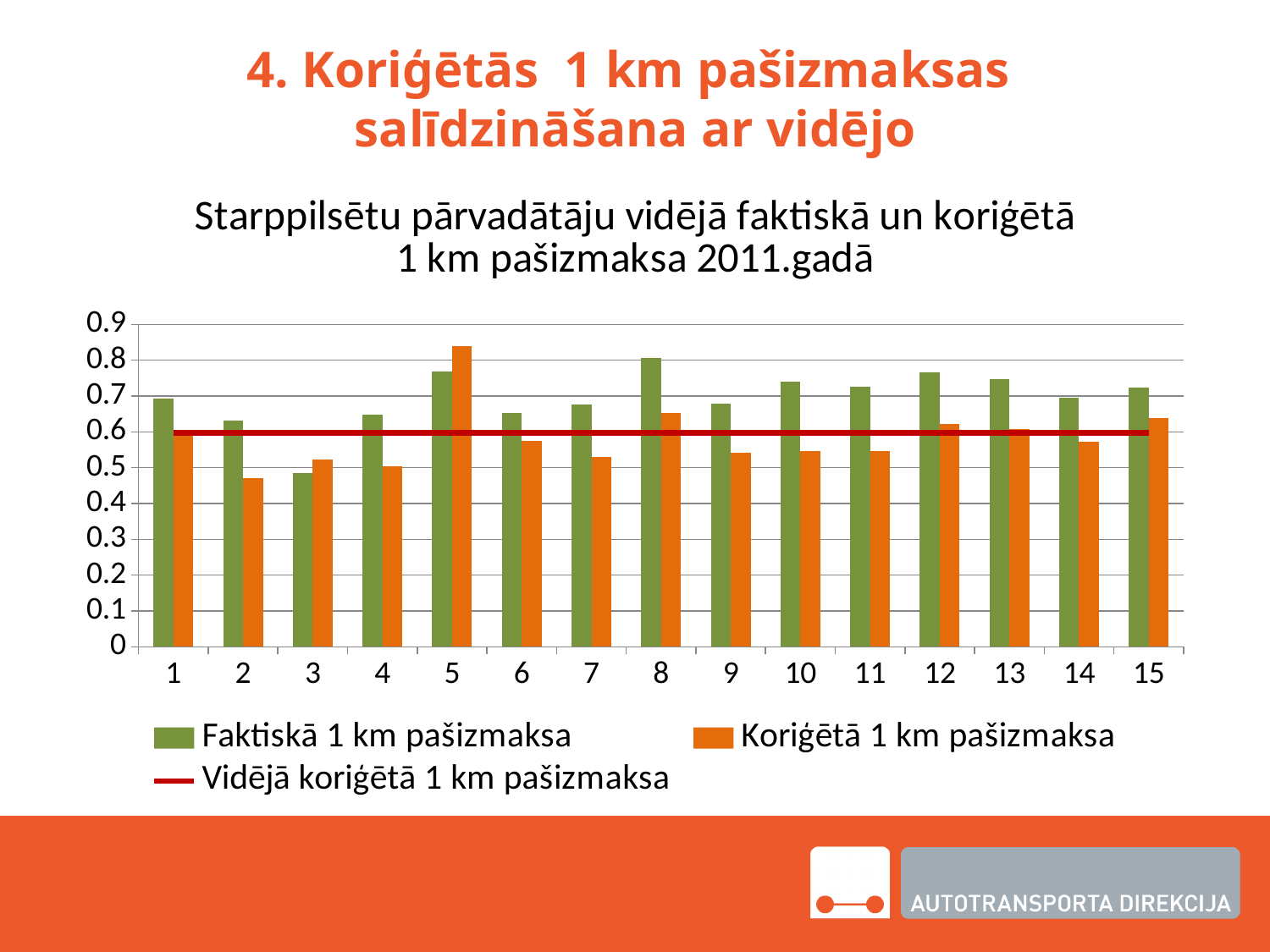
For category 5, which is larger: Faktiskā 1 km pašizmaksa or Koriģētā 1 km pašizmaksa? Koriģētā 1 km pašizmaksa How many series does the legend list? 3 Which category has the highest value for Koriģētā 1 km pašizmaksa? 5 Which category has the lowest value for Koriģētā 1 km pašizmaksa? 2 How many categories are shown on the x axis? 15 Which category has the lowest value for Faktiskā 1 km pašizmaksa? 3 Which category has the highest value for Faktiskā 1 km pašizmaksa? 8 What kind of chart is shown on the slide? combination bar and line chart Which series is drawn as a red horizontal line? Vidējā koriģētā 1 km pašizmaksa Is the Koriģētā 1 km pašizmaksa value for category 5 greater or less than 0.8? greater For category 2, which is larger: Faktiskā 1 km pašizmaksa or Koriģētā 1 km pašizmaksa? Faktiskā 1 km pašizmaksa